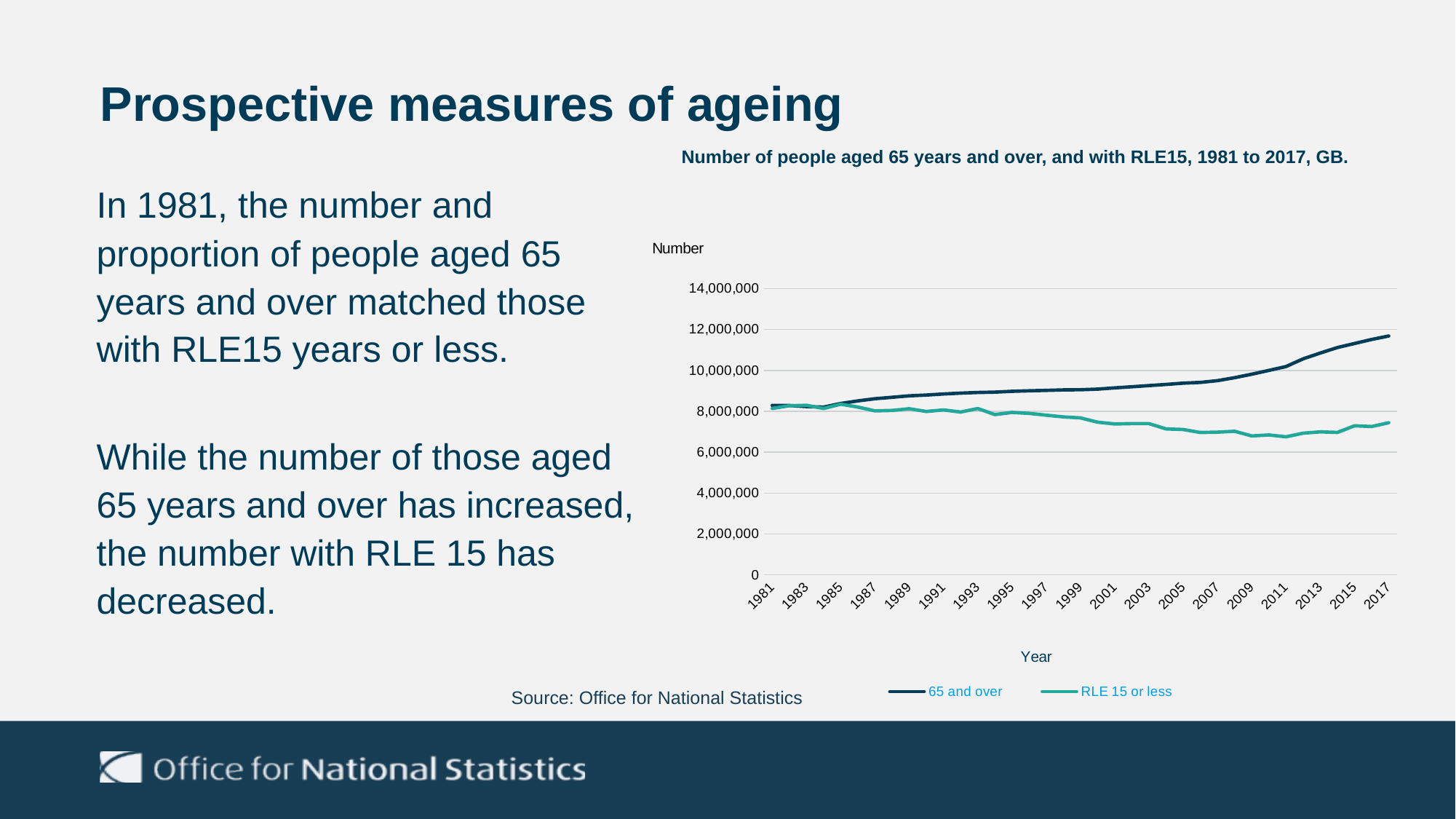
What kind of chart is shown on the slide? Line chart What label is shown on the chart's x axis? Year Does the '65 and over' series rise or fall from 1981 to 2017? Rise How many year labels are shown along the x axis? 19 Is the value for '65 and over' in 2005 greater or less than 10,000,000? less What is the title of the chart? Number of people aged 65 years and over, and with RLE15, 1981 to 2017, GB. Is the value for 'RLE 15 or less' in 2011 greater or less than 8,000,000? less Is the value for '65 and over' in 2017 greater or less than 10,000,000? greater In 2017, which series has the higher value, '65 and over' or 'RLE 15 or less'? 65 and over Overall, does the 'RLE 15 or less' series rise or fall from 1981 to 2017? Fall How many series does the chart's legend list? 2